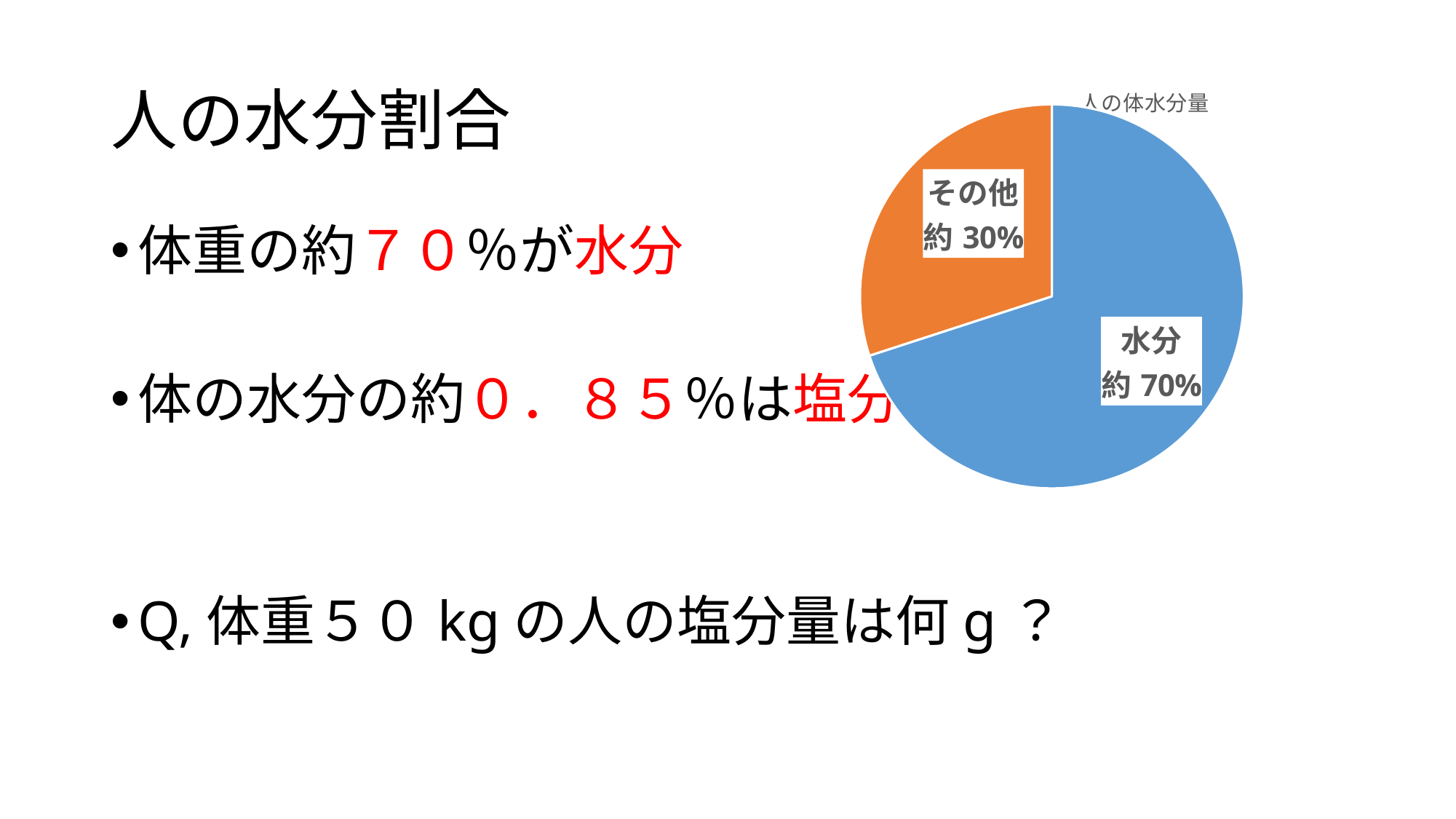
What value is shown for the 水分 slice of the pie chart? 約 70% By how many percentage points does the 水分 slice exceed the その他 slice? 40% What share of the pie does the 水分 slice represent? 約 70% What is the title of the pie chart? 人の体水分量 Which is larger in the pie chart, 水分 or その他? 水分 What kind of chart is shown on the slide? pie chart How many slices does the pie chart have? 2 What value is shown for the その他 slice of the pie chart? 約 30% Which slice of the pie chart is the smallest? その他 What colour is the 水分 slice in the pie chart? blue Which slice of the pie chart is the largest? 水分